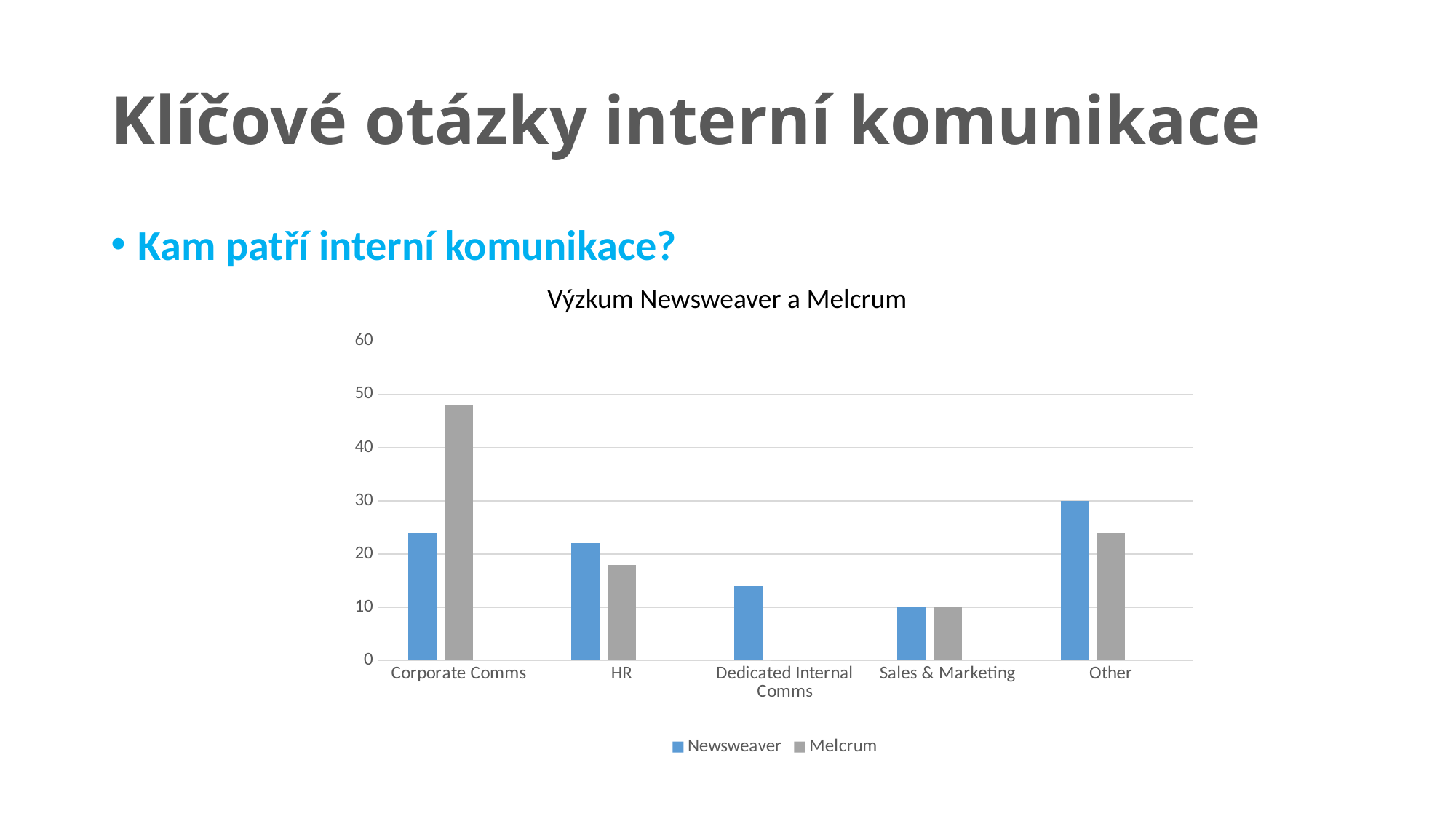
What is the title of the chart? Výzkum Newsweaver a Melcrum How many categories are shown on the x axis? 5 Which category has the highest Newsweaver value? Other For Corporate Comms, which series has the larger value, Newsweaver or Melcrum? Melcrum For HR, which series has the larger value, Newsweaver or Melcrum? Newsweaver Which category has the lowest Newsweaver value? Sales & Marketing How many series does the legend list? 2 What kind of chart is shown on the slide? bar chart Which category has the highest Melcrum value? Corporate Comms Is the Melcrum value for Corporate Comms greater or less than 40? greater Is the Newsweaver value for Dedicated Internal Comms greater or less than 20? less What is the Newsweaver value for Other? 30